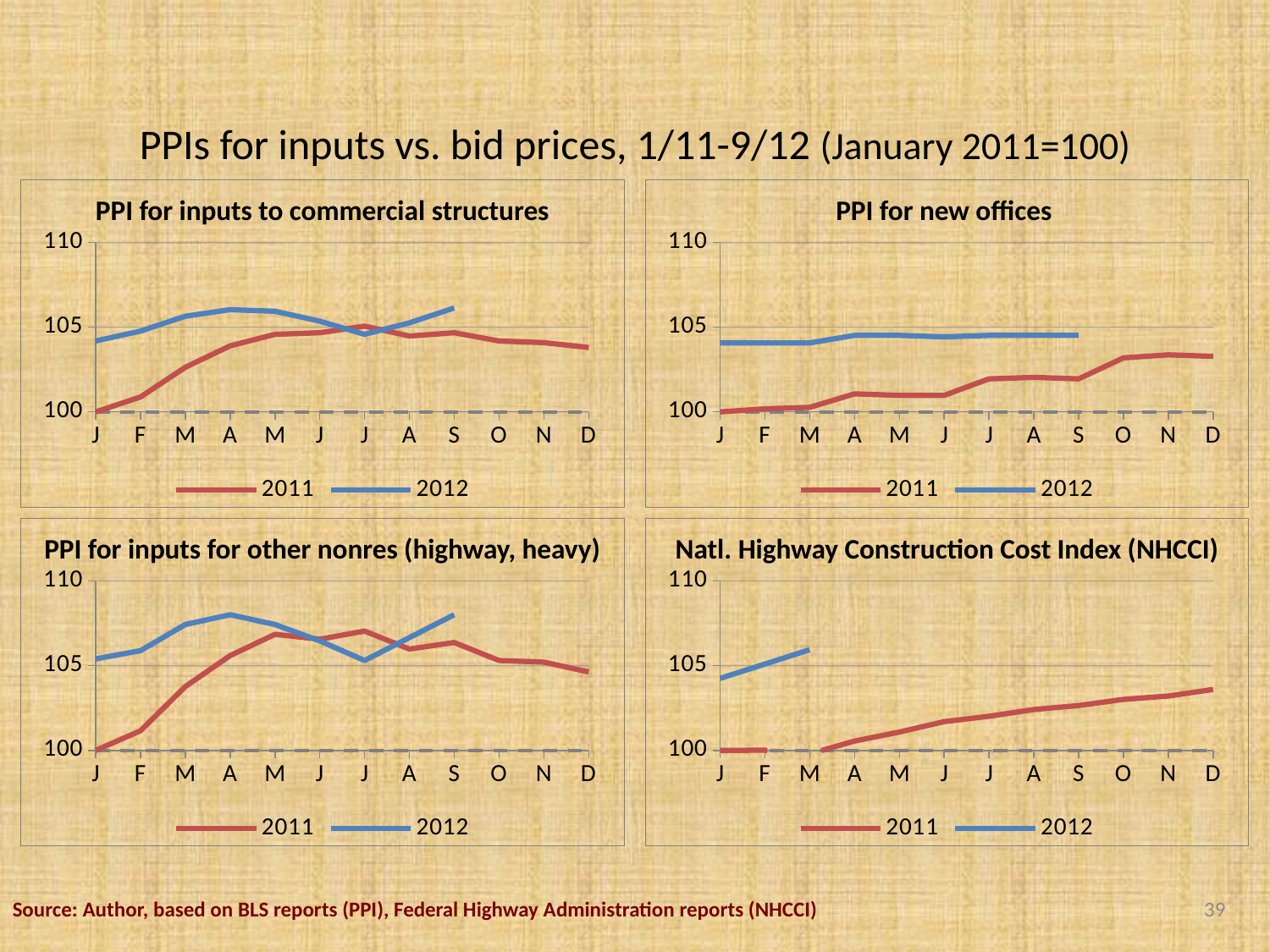
In the 'PPI for new offices' chart, is the value of the 2011 series in December greater or less than 105? less In the 'PPI for inputs to commercial structures' chart, is the value of the 2012 series in April greater or less than 105? greater In the 'PPI for new offices' chart, which series has the higher value in April, 2011 or 2012? 2012 In the 'PPI for new offices' chart, what is the value of the 2011 series in January? 100 In the 'Natl. Highway Construction Cost Index (NHCCI)' chart, how many months are shown on the x axis? 12 How many charts are shown on the slide? 4 In the 'Natl. Highway Construction Cost Index (NHCCI)' chart, does the 2011 series rise or fall from March to December? rise What are the two legend entries in the 'PPI for inputs for other nonres (highway, heavy)' chart? 2011 and 2012 In the 'PPI for inputs for other nonres (highway, heavy)' chart, is the value of the 2012 series in April greater or less than 105? greater In the 'PPI for inputs to commercial structures' chart, how many series does the legend list? 2 In the 'Natl. Highway Construction Cost Index (NHCCI)' chart, which series has the higher value in February, 2011 or 2012? 2012 What kind of chart is the 'PPI for new offices' chart? line chart